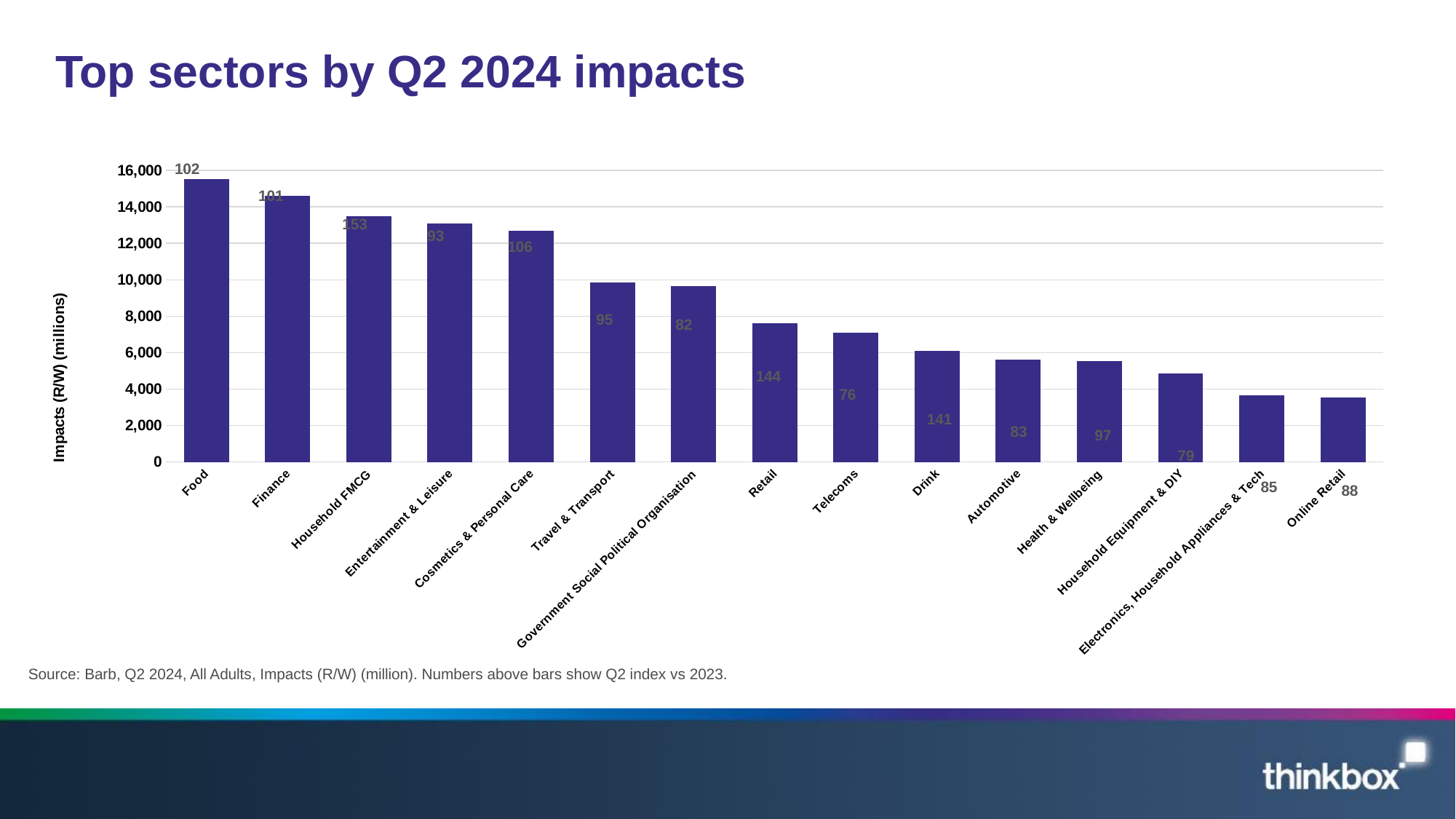
Is the value for Food greater or less than 14,000? greater Which has higher impacts, Finance or Household FMCG? Finance What is the label of the y axis? Impacts (R/W) (millions) Is the value for Telecoms greater or less than 6,000? greater What kind of chart is shown on the slide? bar chart Is the value for Retail greater or less than 8,000? less How many sectors are plotted in the chart? 15 Do the impacts values rise or fall moving from left to right along the x axis? fall Which sector has the highest Q2 2024 impacts? Food What Q2 index vs 2023 is shown above the Household FMCG bar? 153 What Q2 index vs 2023 is shown above the Telecoms bar? 76